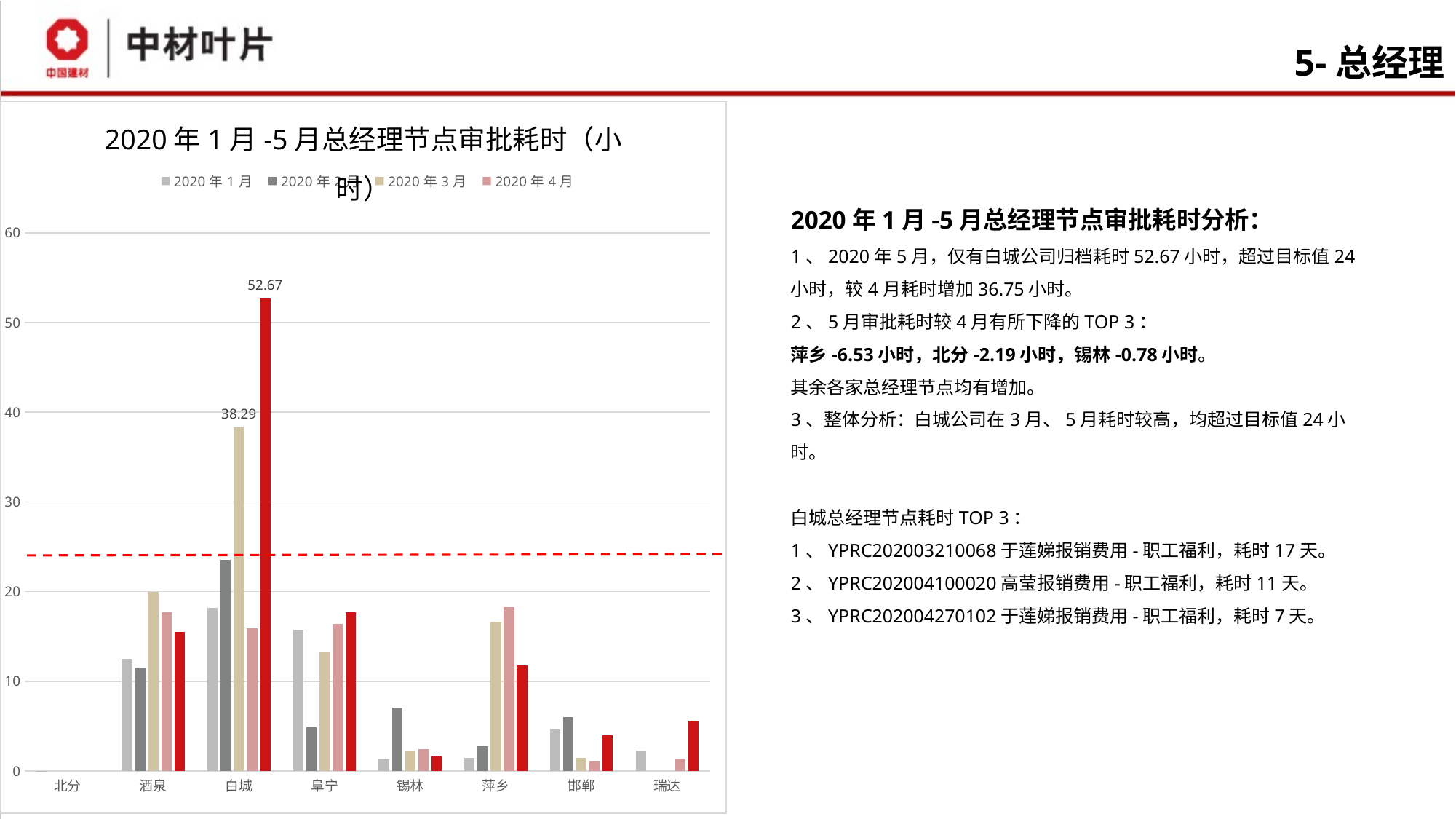
Which is larger for 萍乡, the 2020年1月 value or the 2020年3月 value? 2020年3月 Is the 2020年1月 value for 酒泉 greater or less than 10? greater What is the value of the tallest bar for 白城? 52.67 Which category shows no visible bars in the chart? 北分 Is the 2020年1月 value for 阜宁 greater or less than 20? less What is the difference between the two labeled bars for 白城 (52.67 and 38.29)? 14.38 How many categories are shown on the x axis of the chart? 8 Which category has the tallest bar in the chart? 白城 Which is larger, the 2020年3月 value for 酒泉 or the 2020年3月 value for 阜宁? 酒泉 What kind of chart is shown on the slide? bar chart What is the title of the chart? 2020年1月-5月总经理节点审批耗时（小时） What is the value of the 2020年3月 bar for 白城? 38.29